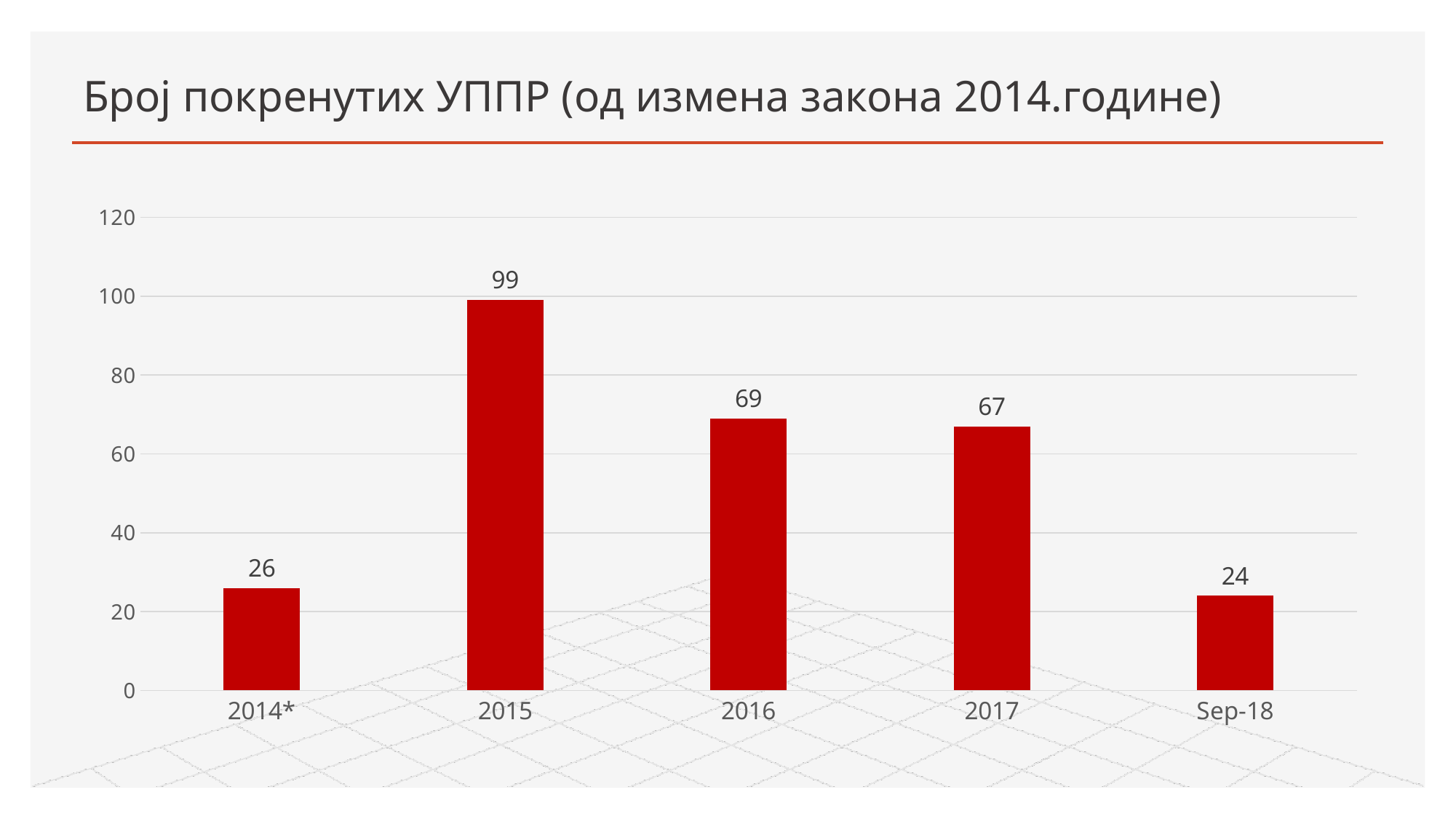
What is the title of the chart? Број покренутих УППР (од измена закона 2014.године) What is the value for 2015? 99 What is the difference between the values for 2015 and 2016? 30 Which is larger, the value for 2016 or the value for 2017? 2016 What is the value for Sep-18? 24 What is the difference between the values for 2017 and Sep-18? 43 Which category has the highest value? 2015 What kind of chart is shown on the slide? bar chart Is the value for 2015 greater or less than 80? greater What is the value for 2014*? 26 Which category has the lowest value? Sep-18 How many categories are shown on the x axis? 5